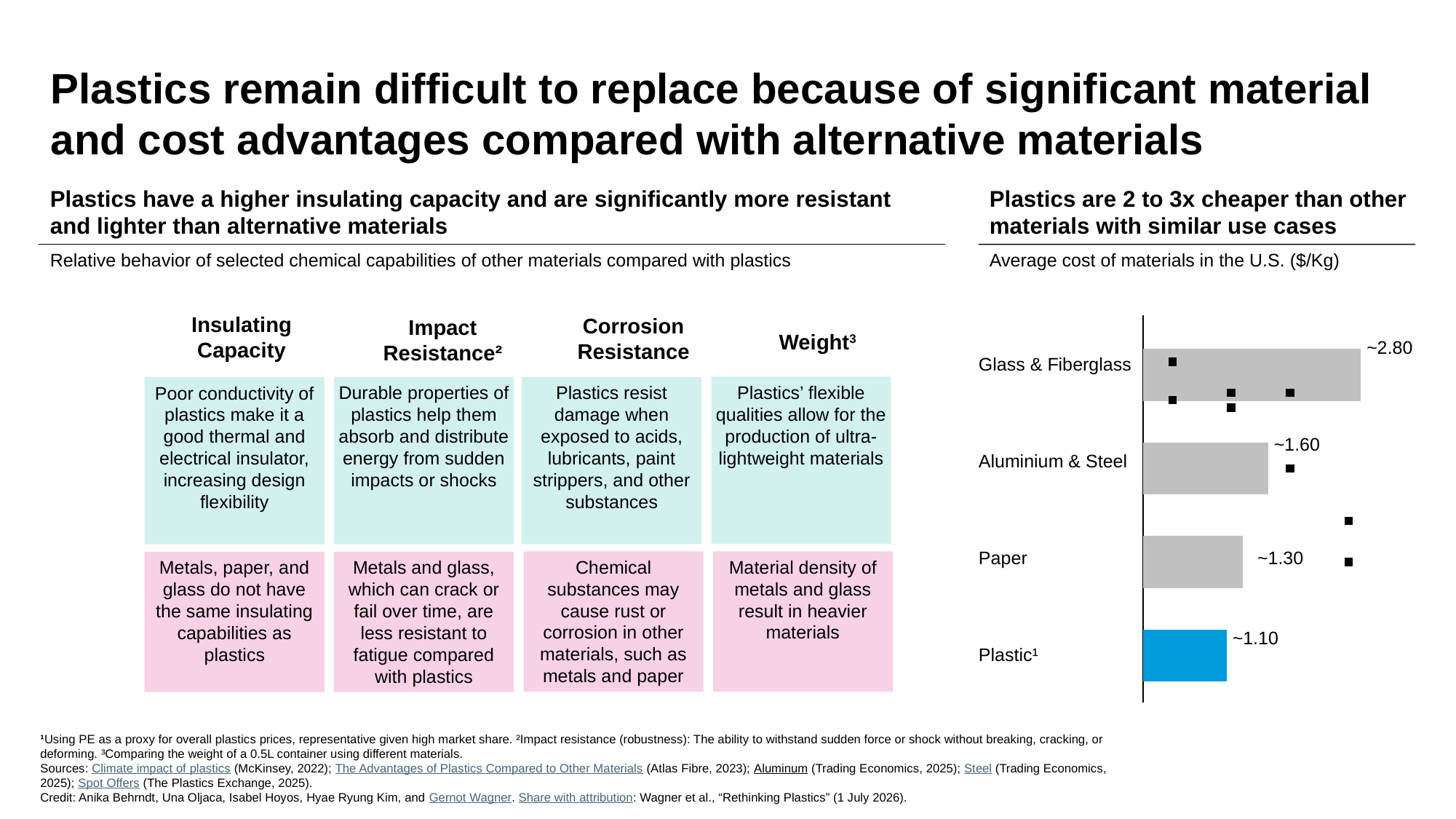
Which bar in the average cost chart is coloured blue rather than grey? Plastic What is the labelled average cost of Aluminium & Steel in the chart? ~1.60 Which material has the highest average cost in the U.S. chart? Glass & Fiberglass Which material has the lowest average cost in the U.S. chart? Plastic In what unit are the values in the average cost of materials chart expressed? $/Kg What is the labelled average cost of Paper in the chart? ~1.30 In the average cost chart, which has the higher value: Glass & Fiberglass or Plastic? Glass & Fiberglass What kind of chart is used to show the average cost of materials in the U.S.? Bar chart In the average cost chart, which has the higher value: Paper or Aluminium & Steel? Aluminium & Steel What is the labelled average cost of Plastic in the chart? ~1.10 How many materials are shown in the average cost of materials chart? 4 What is the labelled average cost of Glass & Fiberglass in the chart? ~2.80